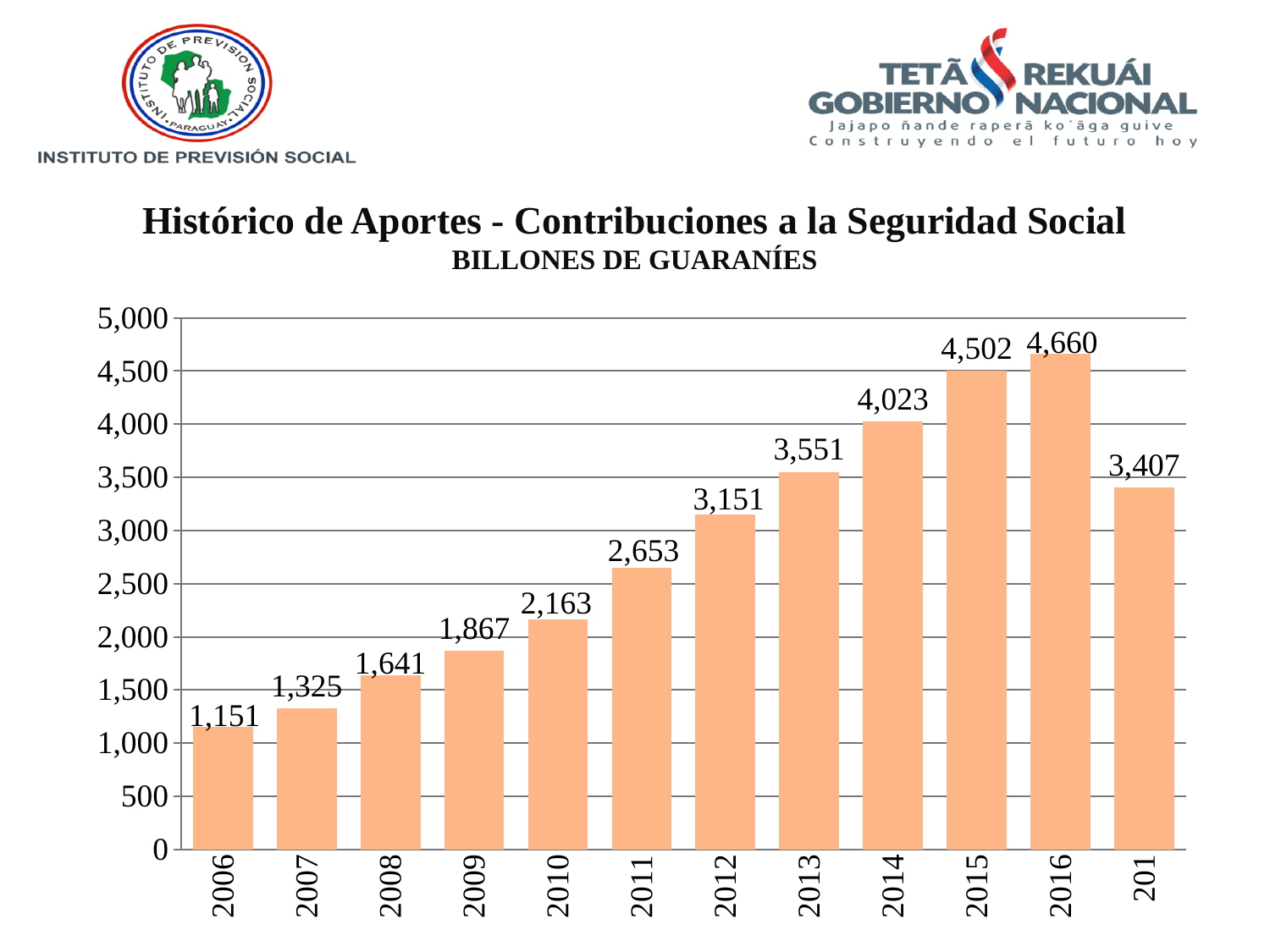
Do the values rise or fall from 2006 to 2016? rise Which is larger, the value for 2009 or the value for 2010? 2010 Is the value for 2012 greater or less than 3,000? greater Which year has the lowest value? 2006 What is the difference between the values for 2014 and 2013? 472 What is the difference between the values for 2016 and 2015? 158 What is the value for 2006? 1,151 What is the value for 2011? 2,653 What is the value for 2015? 4,502 How many bars are plotted in the chart? 12 Which year has the highest value? 2016 What kind of chart is shown on the slide? bar chart